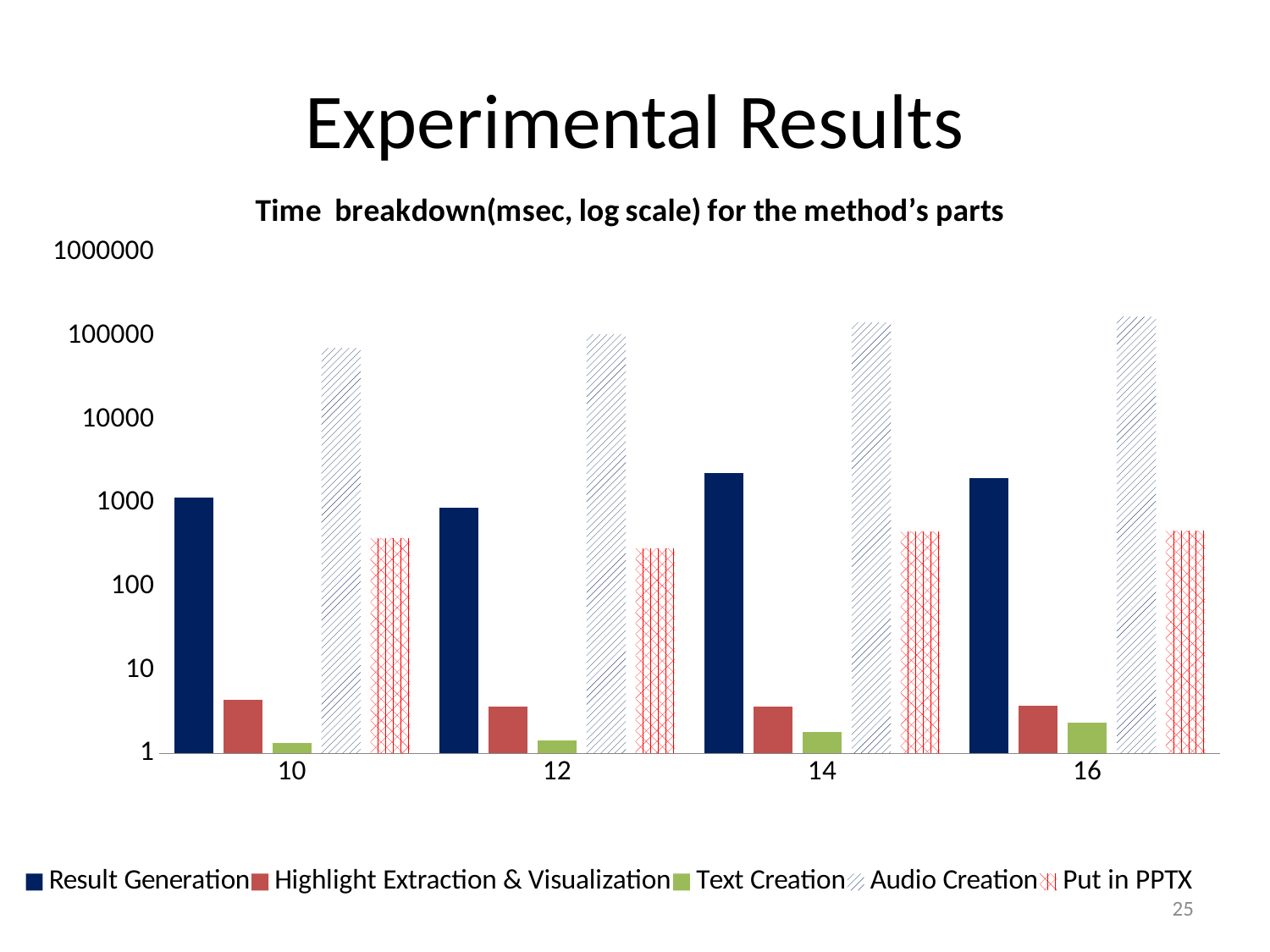
What kind of chart is shown on the slide? bar chart Is the value for Audio Creation at category 16 greater or less than 100000? greater Which series has the lowest value for category 10? Text Creation Is the value for Highlight Extraction & Visualization at category 12 greater or less than 10? less How many categories are shown on the x axis? 4 How many series does the legend list? 5 Which series has the highest value for category 14? Audio Creation Is the value for Audio Creation at category 10 greater or less than 100000? less Which is larger at category 14: Result Generation or Put in PPTX? Result Generation What is the title of the chart? Time breakdown(msec, log scale) for the method's parts Which series is represented by the dark blue solid bars in the legend? Result Generation